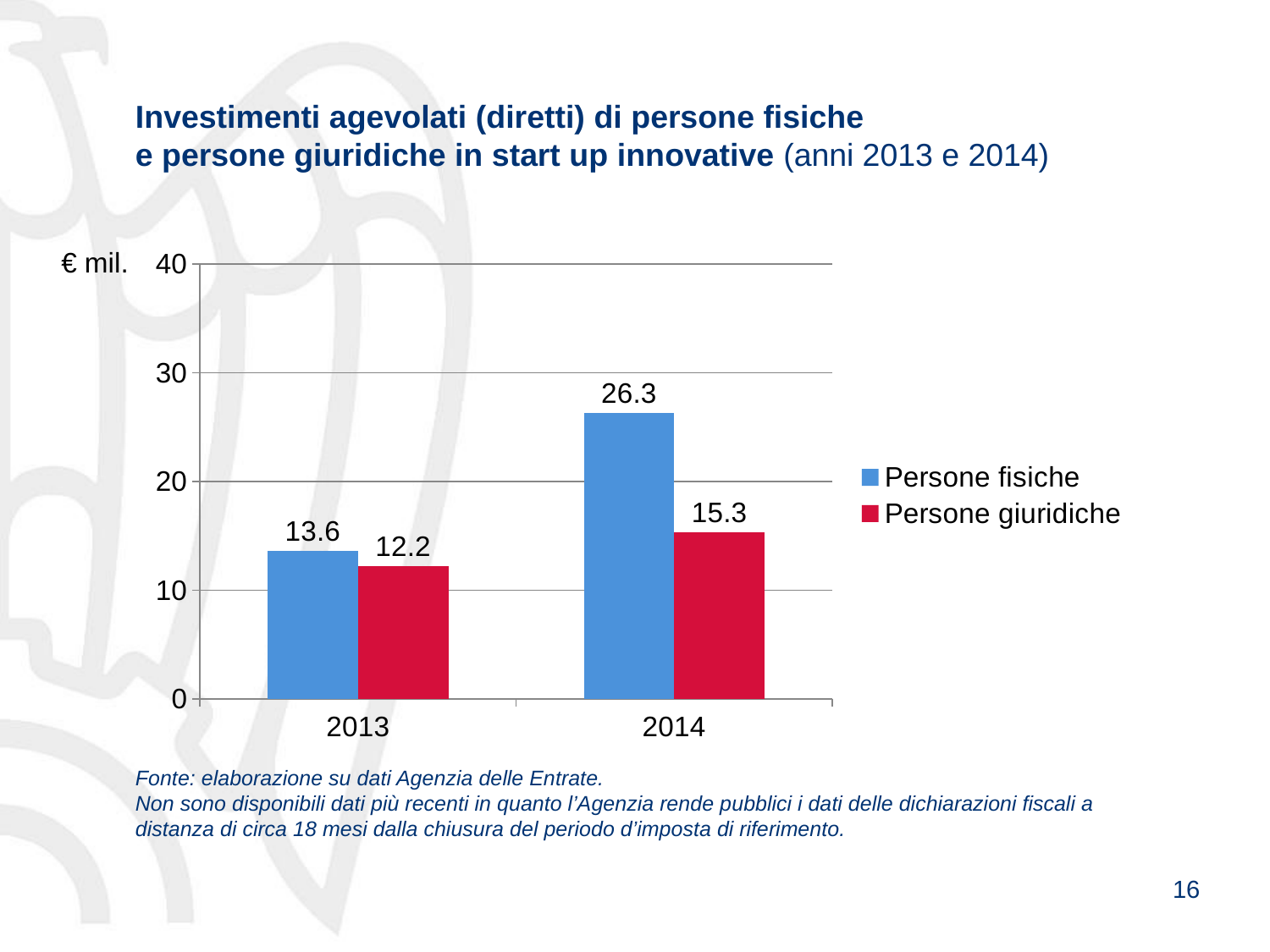
What is the value for Persone giuridiche in 2013? 12.2 Which is larger: Persone giuridiche in 2014 or Persone fisiche in 2013? Persone giuridiche in 2014 What is the value for Persone fisiche in 2014? 26.3 What is the value for Persone giuridiche in 2014? 15.3 What is the value for Persone fisiche in 2013? 13.6 Which series has the lowest value in 2013? Persone giuridiche How many series does the legend list? 2 By how much did Persone fisiche increase from 2013 to 2014? 12.7 What kind of chart is shown on the slide? Bar chart Which year has the highest value for Persone fisiche? 2014 What is the difference between Persone fisiche and Persone giuridiche in 2014? 11.0 How many years are shown on the x axis? 2